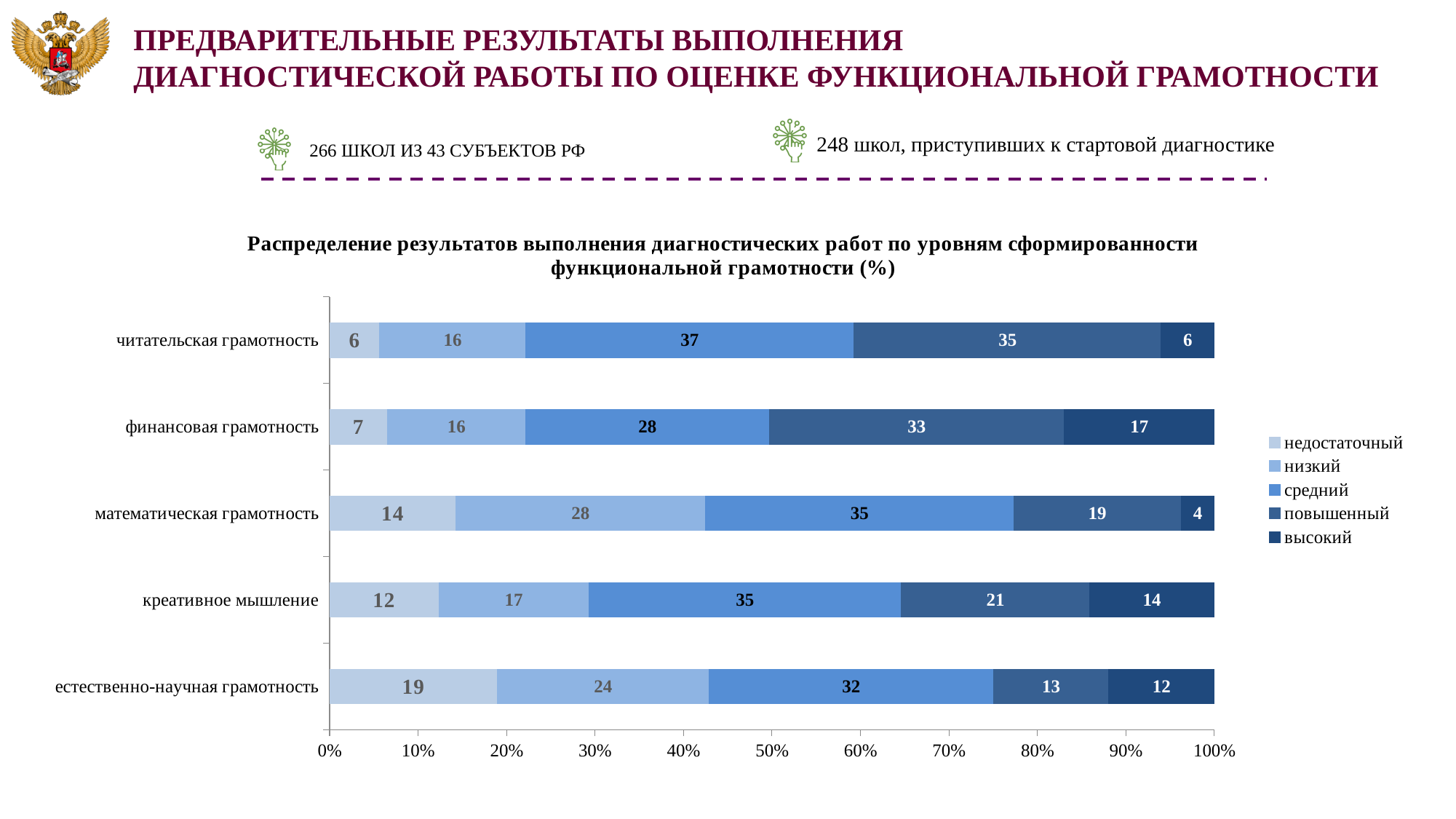
What kind of chart is shown on the slide? stacked bar chart Which category has the highest value for the недостаточный level? естественно-научная грамотность What is the difference between the повышенный values for читательская грамотность and естественно-научная грамотность? 22 What is the value of the средний segment for читательская грамотность? 37 What is the total of the printed segment values for креативное мышление? 99 Which legend entry corresponds to the darkest blue segments? высокий How many series does the legend list? 5 How many categories (types of literacy) are shown on the chart? 5 What is the value of the недостаточный segment for естественно-научная грамотность? 19 What is the value of the высокий segment for финансовая грамотность? 17 Which category has the lowest value for the высокий level? математическая грамотность Which has the larger низкий value: математическая грамотность or креативное мышление? математическая грамотность